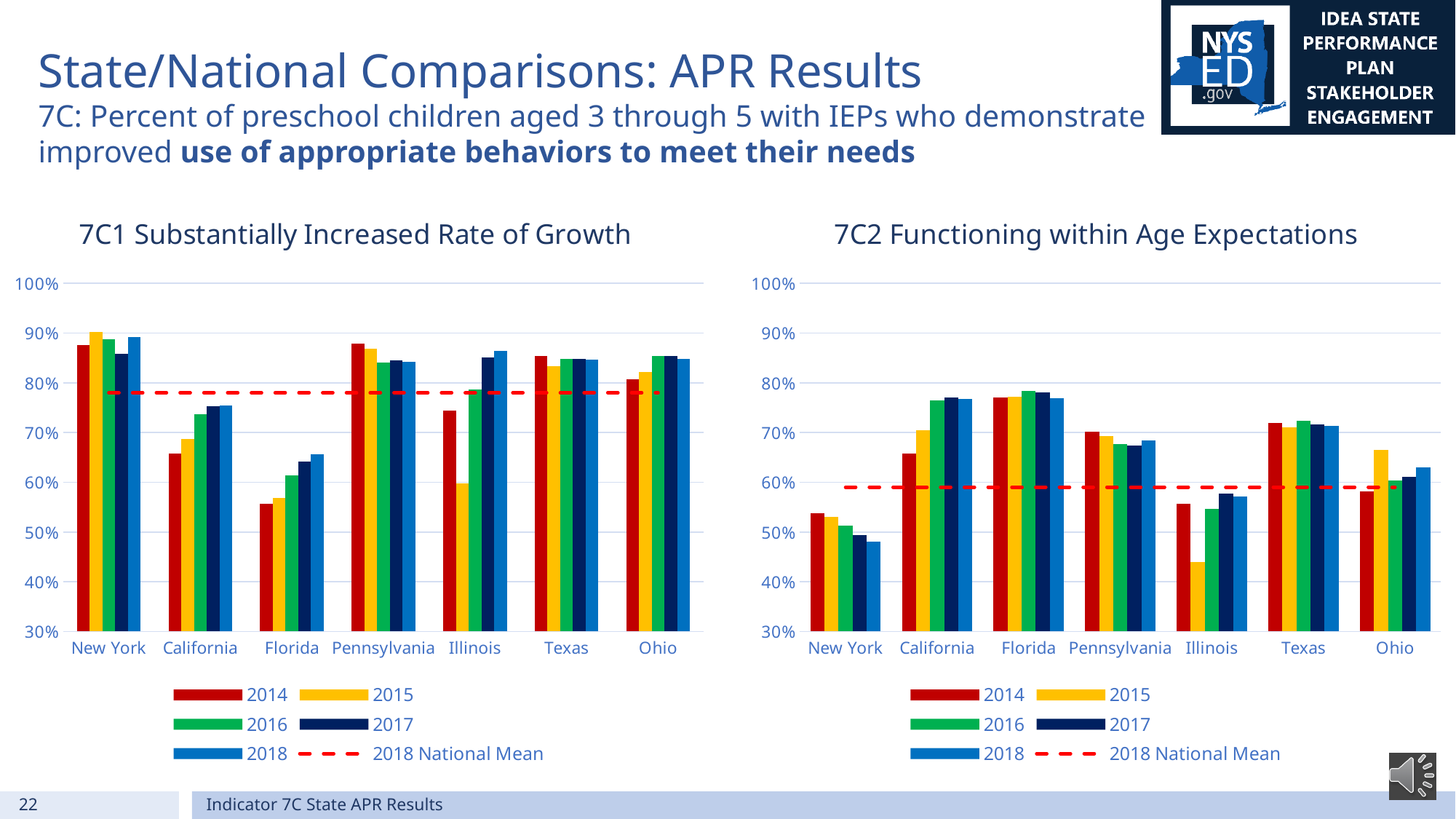
In the 7C1 Substantially Increased Rate of Growth chart, is the 2014 value for Florida greater or less than 60%? less How many entries does the legend of the 7C2 Functioning within Age Expectations chart list? 6 In the 7C1 Substantially Increased Rate of Growth chart, which state has the lowest 2014 value? Florida In the 7C2 Functioning within Age Expectations chart, how is the 2018 National Mean shown? red dashed line In the 7C2 Functioning within Age Expectations chart, is the 2015 value for Illinois greater or less than 50%? less In the 7C2 Functioning within Age Expectations chart, which state has the lowest 2018 value? New York In the 7C2 Functioning within Age Expectations chart, do New York's values rise or fall from 2014 to 2018? fall How many states are shown on the x axis of the 7C1 Substantially Increased Rate of Growth chart? 7 In the 7C1 Substantially Increased Rate of Growth chart, is the 2015 value for Illinois greater or less than 70%? less What kind of chart is the 7C1 Substantially Increased Rate of Growth chart? bar chart In the 7C2 Functioning within Age Expectations chart, which state has the highest 2015 value? Florida In the 7C1 Substantially Increased Rate of Growth chart, do Florida's values rise or fall from 2014 to 2018? rise